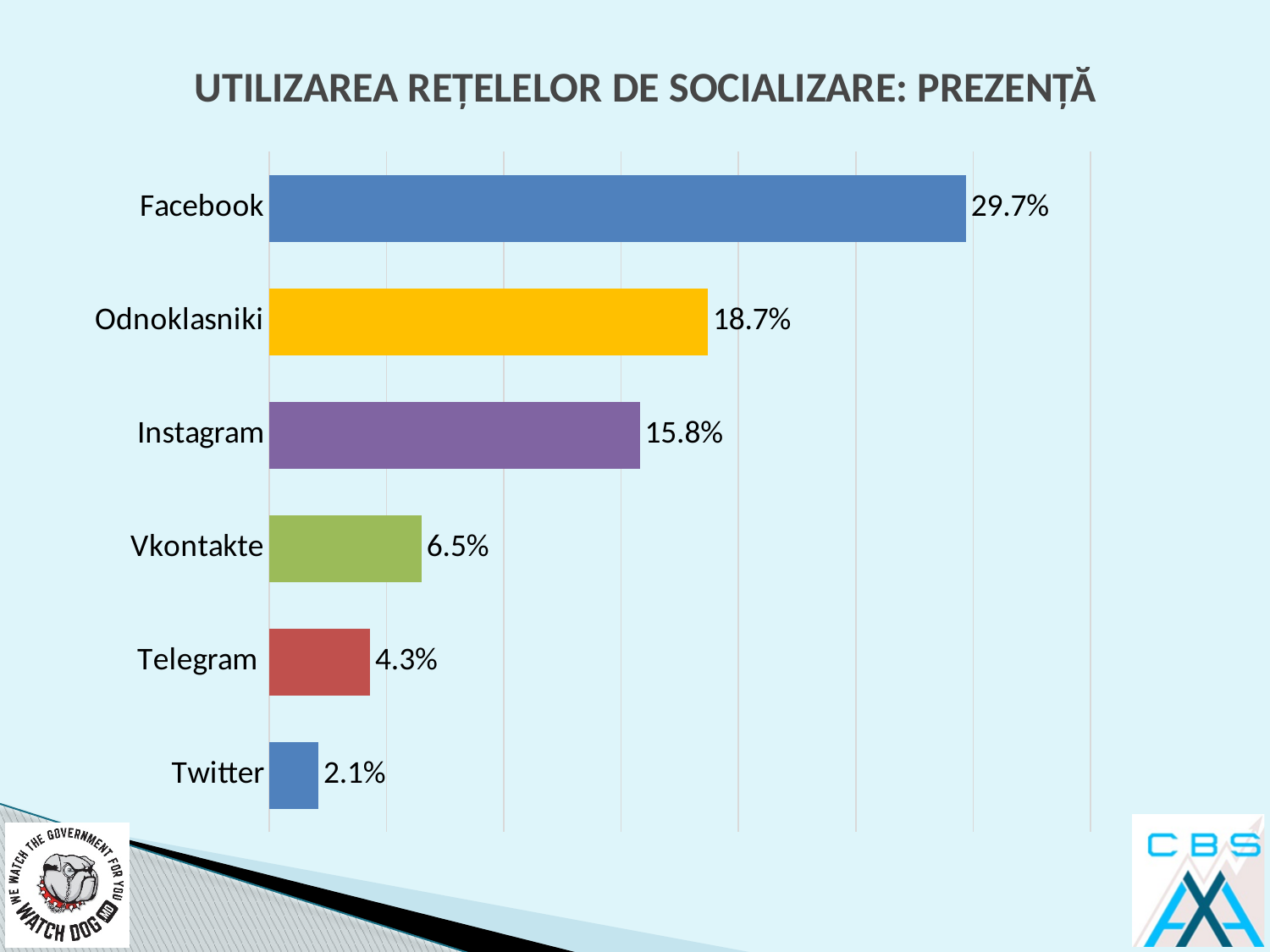
What is the difference between the values for Facebook and Odnoklasniki? 11.0% What kind of chart is shown on the slide? Bar chart Which is larger, the value for Vkontakte or the value for Telegram? Vkontakte What is the value for Vkontakte? 6.5% Which social network has the lowest value? Twitter What is the value for Instagram? 15.8% What is the value for Twitter? 2.1% What is the value for Odnoklasniki? 18.7% What is the value for Telegram? 4.3% How many social networks are shown in the chart? 6 Which social network has the highest value? Facebook What is the value for Facebook? 29.7%